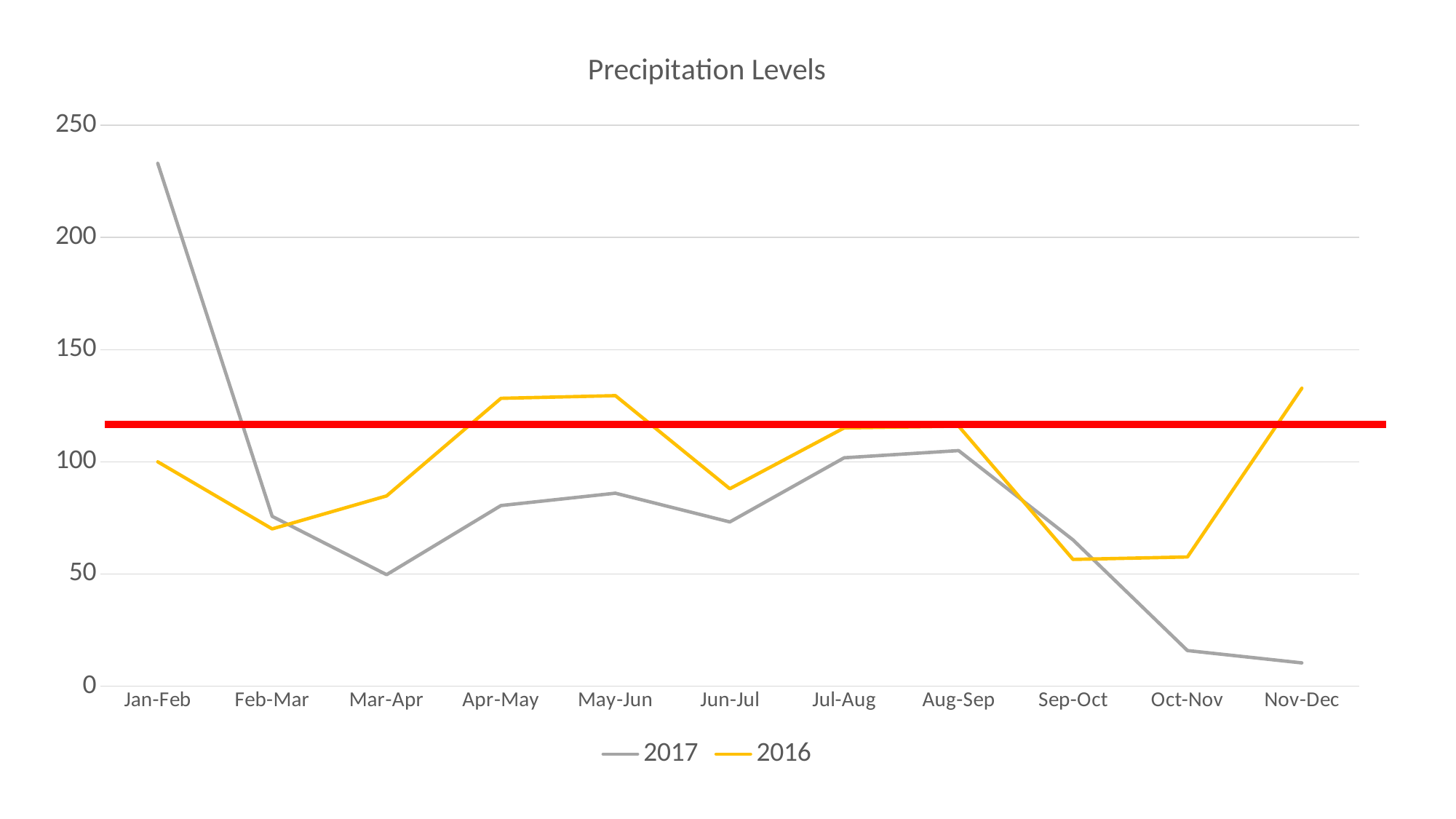
In Nov-Dec, which series has the larger value, 2017 or 2016? 2016 Is the 2017 value for Nov-Dec greater or less than 50? less How many series does the legend list? 2 What is the title of the chart? Precipitation Levels For the 2017 series, which category has the highest value? Jan-Feb What kind of chart is shown on the slide? Line chart How many categories are shown along the x axis? 11 Is the 2016 value for Apr-May greater or less than 100? greater In Jan-Feb, which series has the larger value, 2017 or 2016? 2017 Is the 2017 value for Jan-Feb greater or less than 200? greater Does the 2017 series rise or fall from Aug-Sep to Nov-Dec? fall For the 2017 series, which category has the lowest value? Nov-Dec